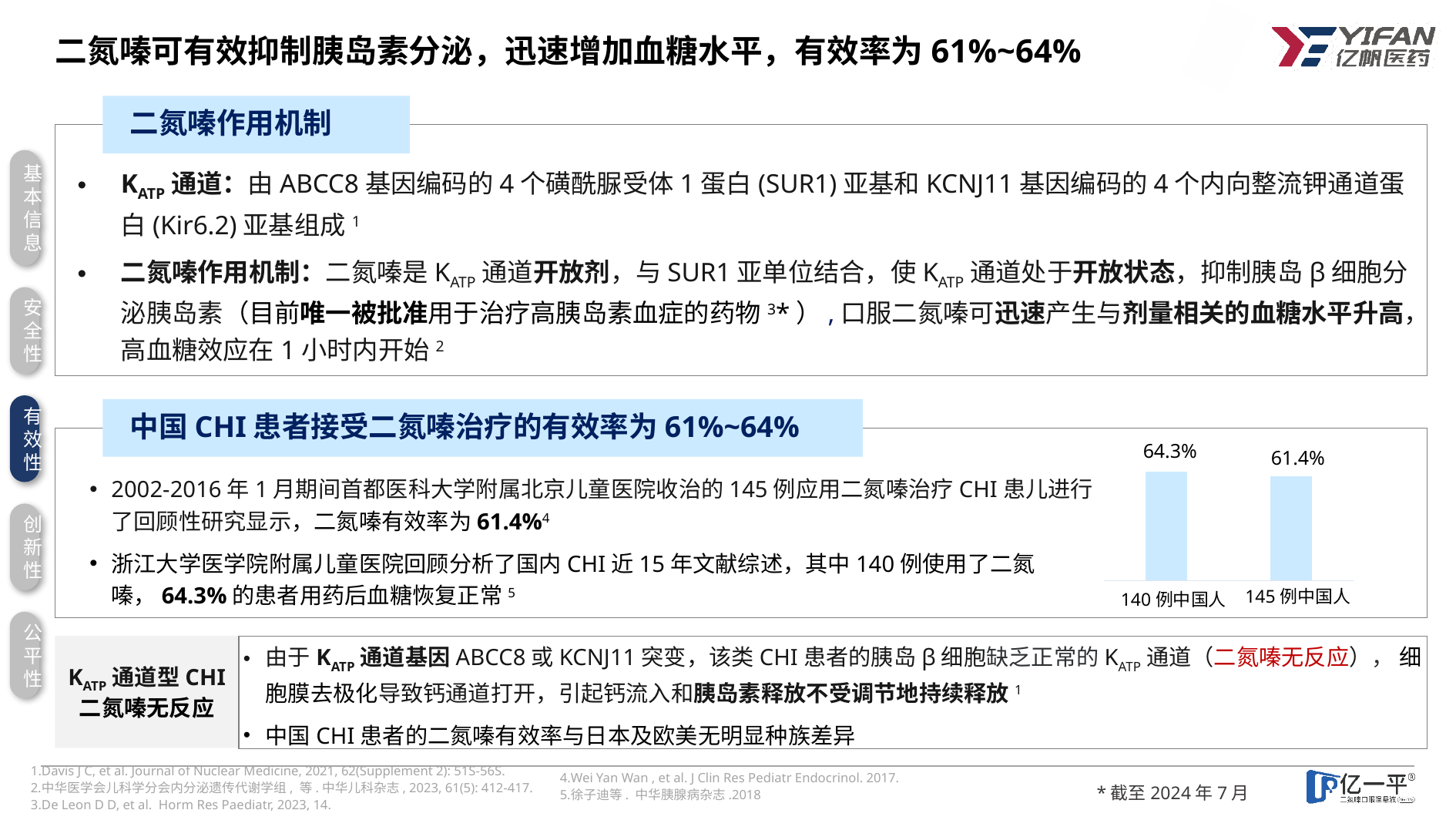
How many bars are plotted in the chart? 2 Which category has the higher value in the bar chart? 140 例中国人 What is the value shown for 140 例中国人 in the bar chart? 64.3% Is the value for 140 例中国人 larger or smaller than the value for 145 例中国人? larger Which category has the lower value in the bar chart? 145 例中国人 What is the value shown for 145 例中国人 in the bar chart? 61.4% What colour are the bars in the chart? light blue What kind of chart is shown on the slide? bar chart What is the label of the left bar in the chart? 140 例中国人 What is the difference between the values for 140 例中国人 and 145 例中国人 in the bar chart? 2.9% Do the values rise or fall from left to right across the bars? fall